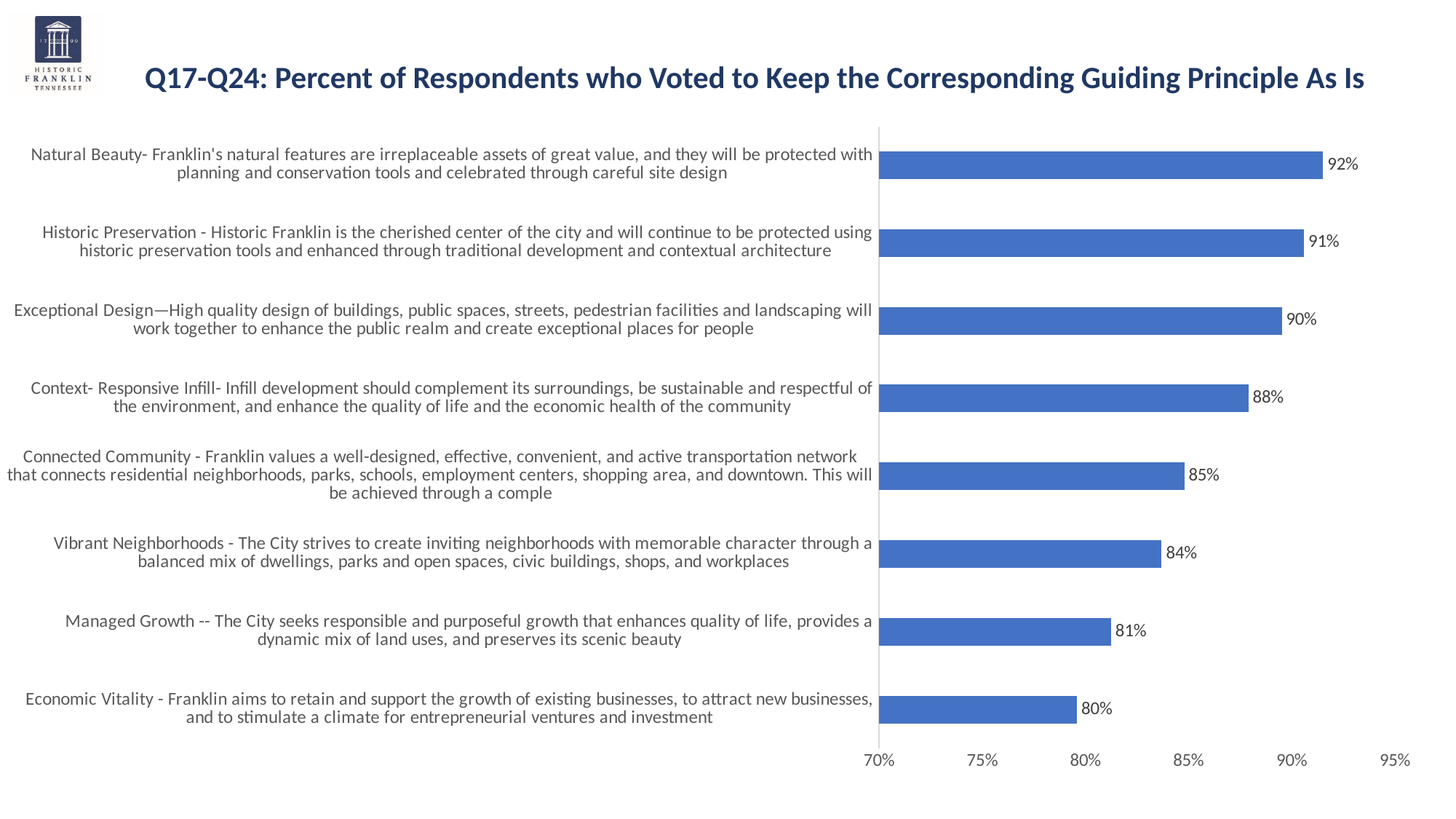
Which guiding principle has the highest percent of respondents voting to keep it as is? Natural Beauty What is the difference between the values for Historic Preservation and Economic Vitality? 11% Is the value for Vibrant Neighborhoods greater or less than 80%? greater Which has a higher value, Exceptional Design or Managed Growth? Exceptional Design What is the value shown for the Connected Community guiding principle? 85% How many guiding principles are shown in the chart? 8 What percent of respondents voted to keep the Natural Beauty guiding principle as is? 92% What is the difference between the values for Context-Responsive Infill and Vibrant Neighborhoods? 4% What kind of chart is shown on the slide? Bar chart What is the value shown for the Managed Growth guiding principle? 81% What is the title of the chart? Q17-Q24: Percent of Respondents who Voted to Keep the Corresponding Guiding Principle As Is Which guiding principle has the lowest percent of respondents voting to keep it as is? Economic Vitality